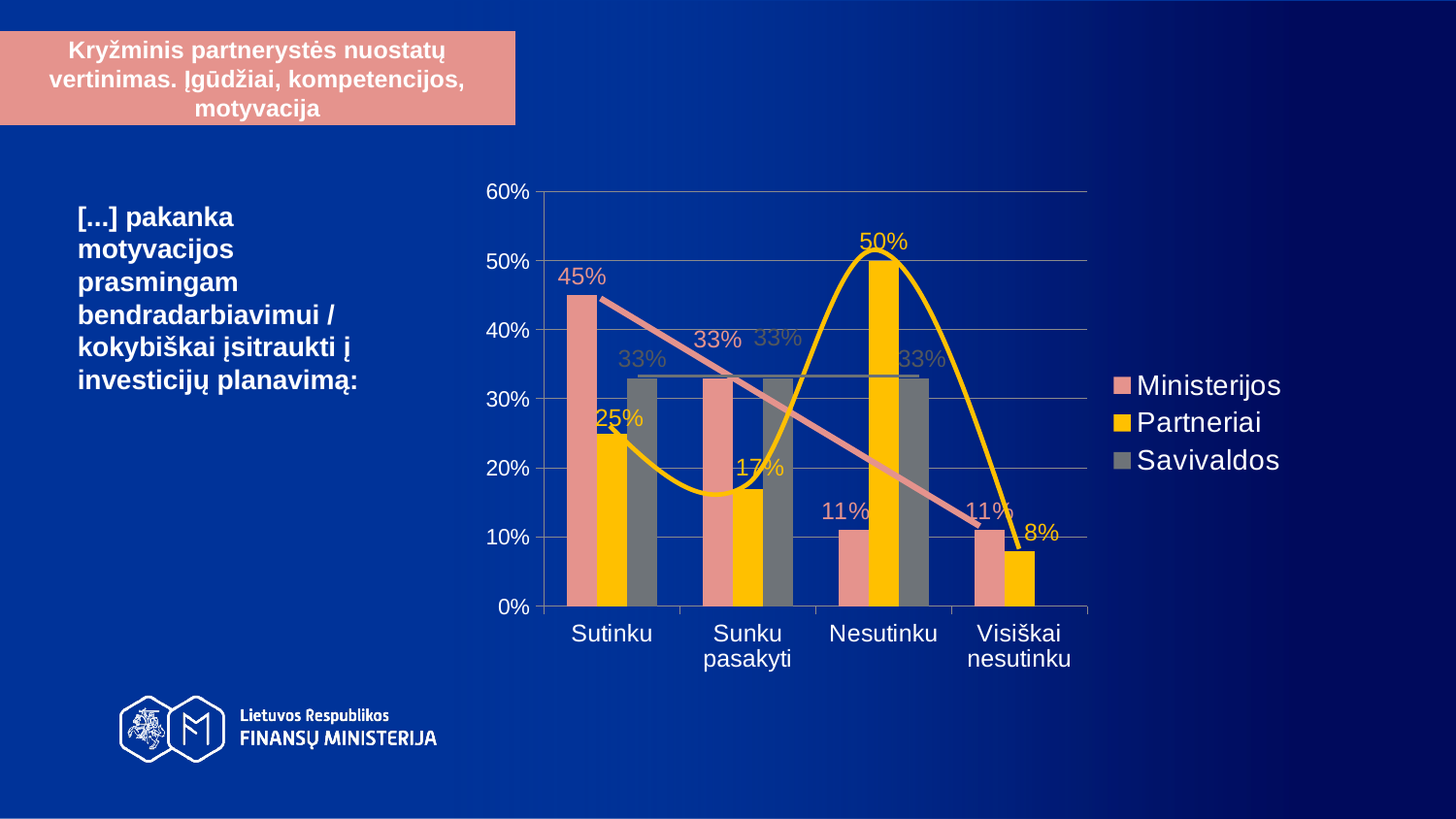
Which is larger in the Nesutinku category: Ministerijos or Partneriai? Partneriai In which category does the Partneriai series reach its highest value? Nesutinku What is the value for Partneriai in the Visiškai nesutinku category? 8% What is the value for Partneriai in the Sunku pasakyti category? 17% How many categories are shown on the x axis? 4 In which category does the Partneriai series have its lowest value? Visiškai nesutinku What is the value for Partneriai in the Nesutinku category? 50% Does the Ministerijos series rise or fall from Sutinku to Visiškai nesutinku? Fall What is the value for Ministerijos in the Sutinku category? 45% What is the difference between the Ministerijos and Partneriai values in the Sutinku category? 20% How many series does the legend list? 3 What kind of chart is shown on the slide? Bar chart